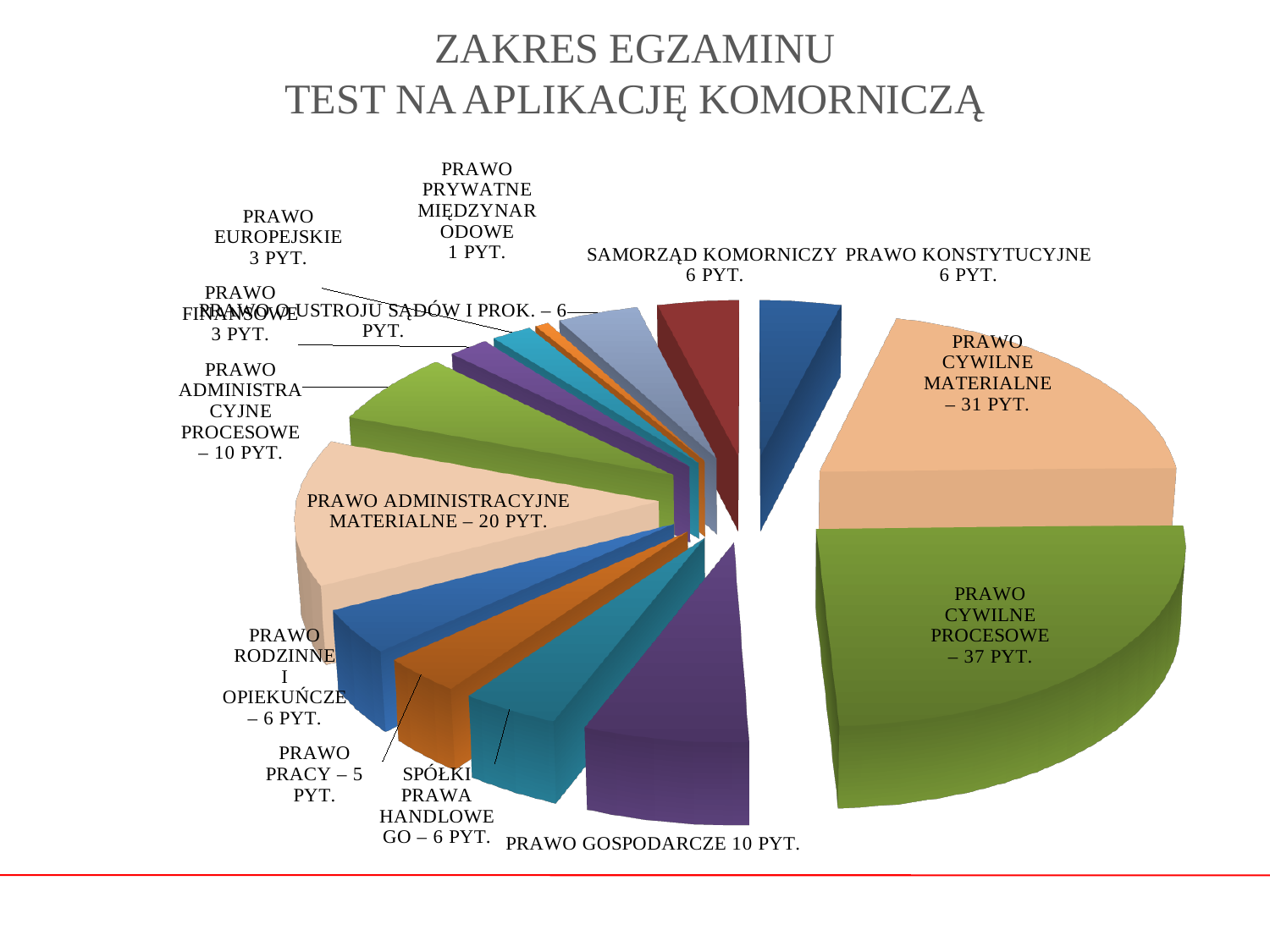
What is the difference in the number of questions between PRAWO PRACY and PRAWO EUROPEJSKIE? 2 How many questions are allocated to PRAWO PRYWATNE MIĘDZYNARODOWE? 1 PYT. What type of chart is shown on the slide? Pie chart Which subject area has the smallest number of questions? PRAWO PRYWATNE MIĘDZYNARODOWE How many questions (PYT.) are allocated to PRAWO CYWILNE PROCESOWE? 37 PYT. How many questions are allocated to PRAWO ADMINISTRACYJNE MATERIALNE? 20 PYT. Which has more questions, PRAWO ADMINISTRACYJNE MATERIALNE or PRAWO ADMINISTRACYJNE PROCESOWE? PRAWO ADMINISTRACYJNE MATERIALNE What is the title of the slide containing the chart? ZAKRES EGZAMINU TEST NA APLIKACJĘ KOMORNICZĄ How many questions are allocated to PRAWO GOSPODARCZE? 10 PYT. Which subject area has the largest number of questions? PRAWO CYWILNE PROCESOWE How many questions are allocated to PRAWO CYWILNE MATERIALNE? 31 PYT. What is the difference in the number of questions between PRAWO CYWILNE PROCESOWE and PRAWO CYWILNE MATERIALNE? 6